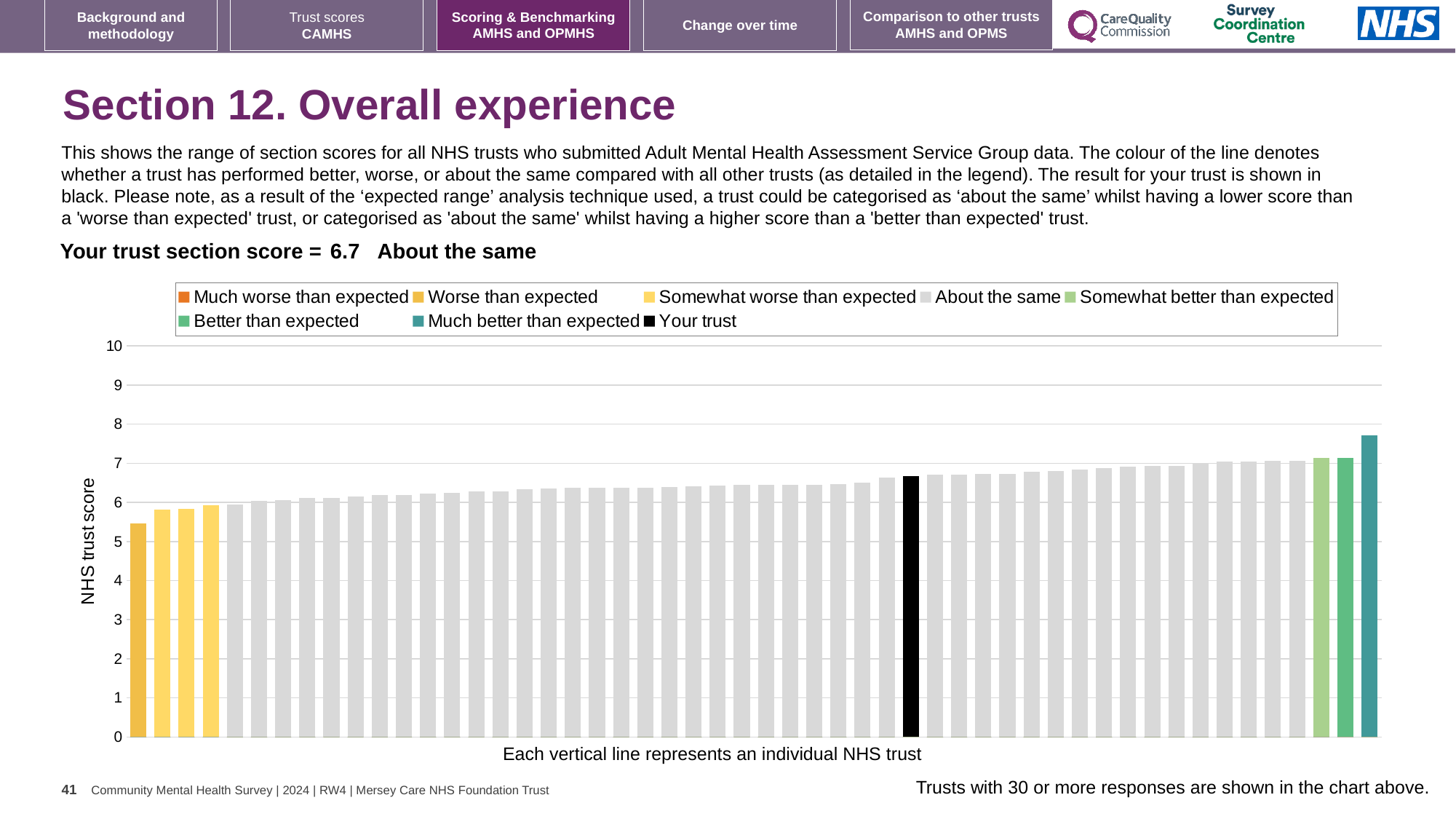
What is the section score for your trust shown on the slide? 6.7 What is the label on the y axis of the chart? NHS trust score Which legend category does the tallest bar belong to? Much better than expected Do the bar values rise or fall from left to right along the x axis? rise Is the black 'Your trust' bar higher or lower than the teal 'Much better than expected' bar? lower Is the value of the leftmost (lowest) bar greater or less than 6? less What kind of chart is shown on the slide? bar chart Is the value of the tallest bar greater or less than 7? greater Is the value for your trust (the black bar) greater or less than 6? greater How many entries does the chart legend list? 8 How many bars are coloured as 'Somewhat better than expected' (light green)? 1 What colour is the bar representing your trust? black